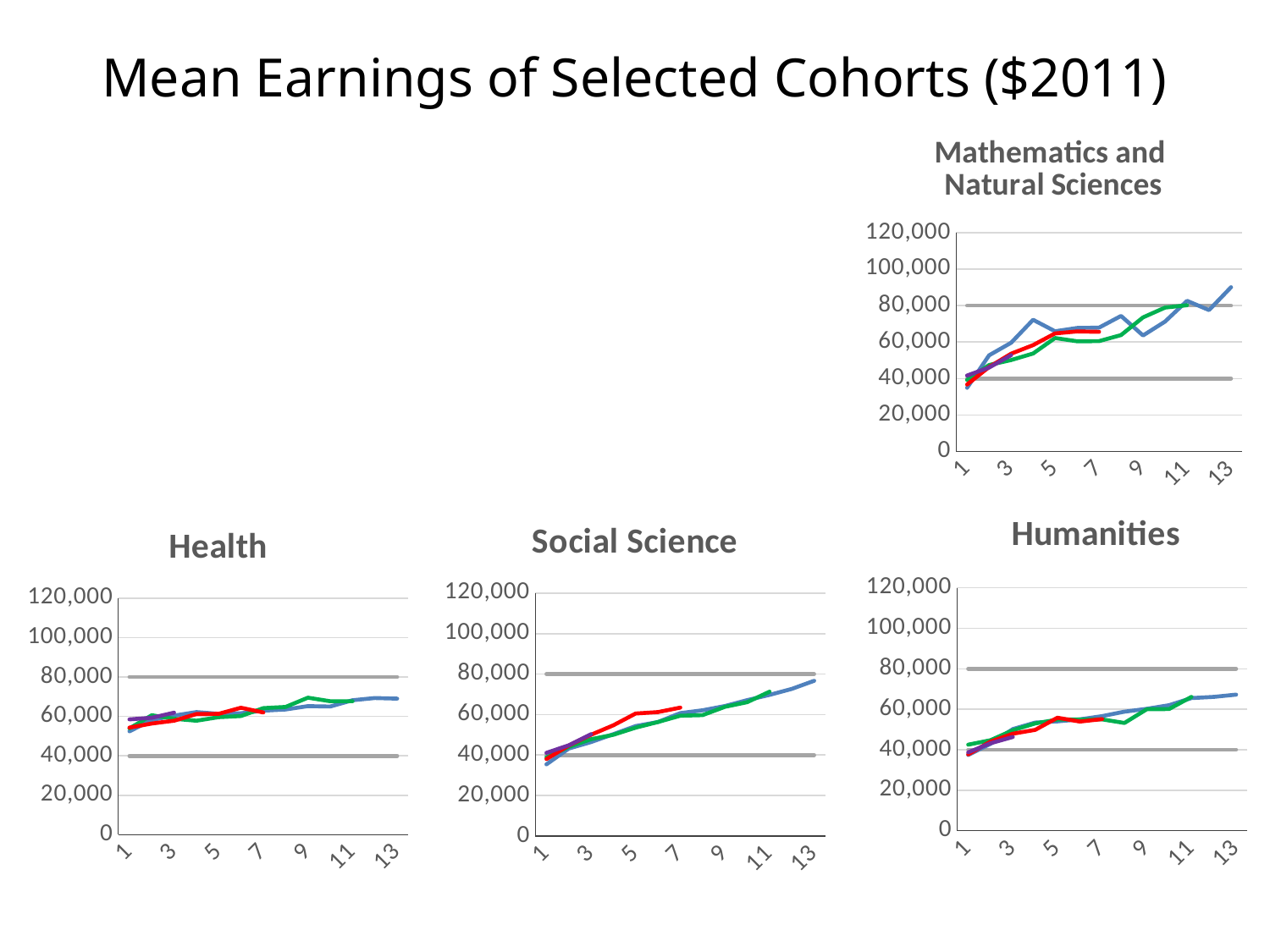
In the Mathematics and Natural Sciences chart, is the value of the blue line at x = 13 greater or less than 80,000? greater In the Humanities chart, is the value of the blue line at x = 13 greater or less than 80,000? less In the Social Science chart, is the value of the blue line at x = 13 greater or less than 80,000? less In the Mathematics and Natural Sciences chart, does the blue line generally rise or fall from x = 1 to x = 13? rise In the Social Science chart, do the plotted lines generally rise or fall as x increases from 1 to 13? rise What is the highest value shown on the y axis of the Humanities chart? 120,000 How many charts are shown on the slide? 4 What kind of chart is the Health chart? line chart What is the title of the chart in the top right of the slide? Mathematics and Natural Sciences What is the title of the slide? Mean Earnings of Selected Cohorts ($2011)